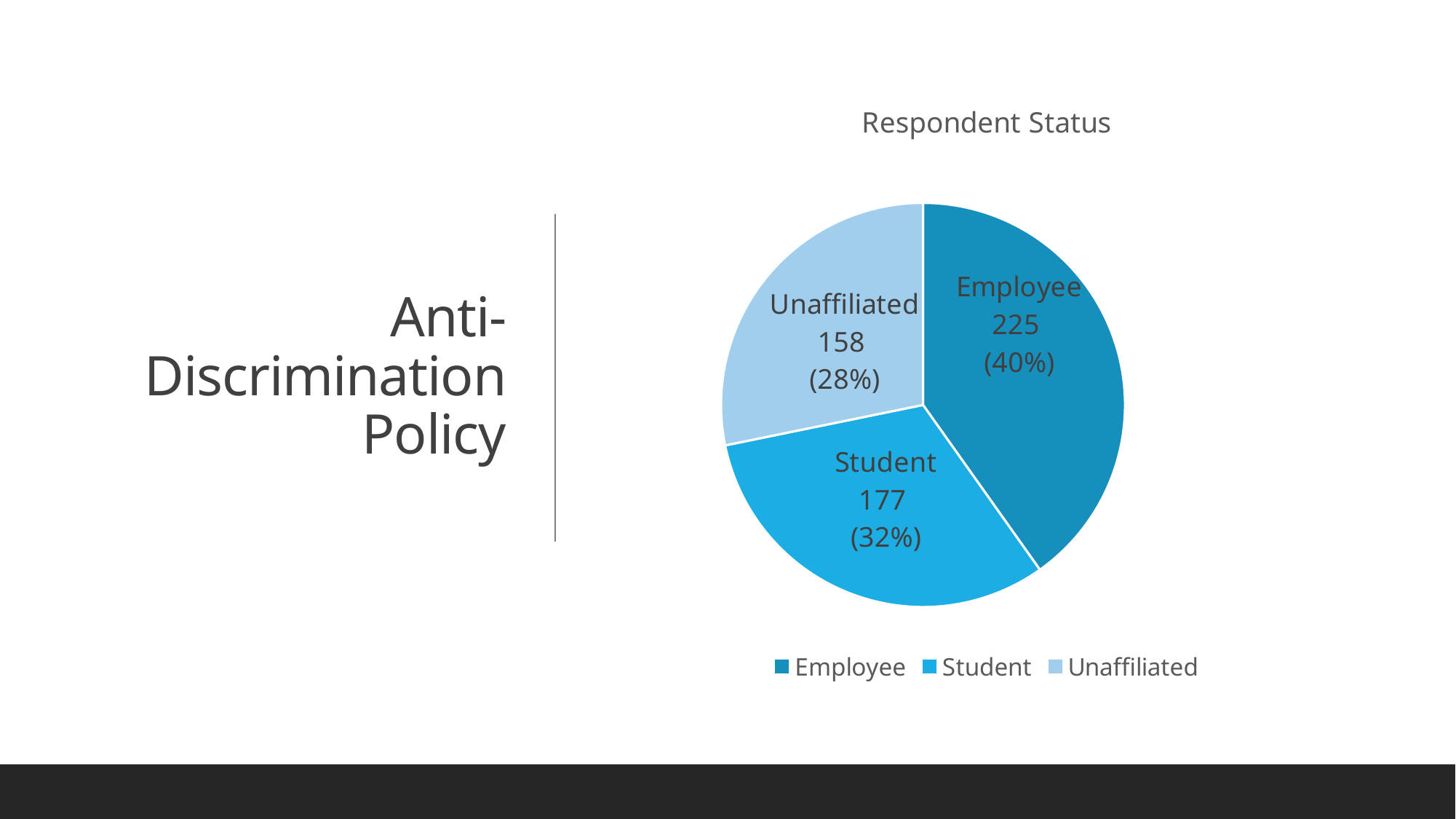
What is the value for Employee? 225 How many slices does the pie chart have? 3 What share of the pie does Student represent? 32% Which category has the largest slice? Employee Which is larger, the value for Student or the value for Unaffiliated? Student How many entries does the legend list? 3 What is the value for Student? 177 What kind of chart is shown on the slide? pie chart What is the value for Unaffiliated? 158 What is the difference between the Employee and Unaffiliated values? 67 Which category has the smallest slice? Unaffiliated What is the title of the chart? Respondent Status